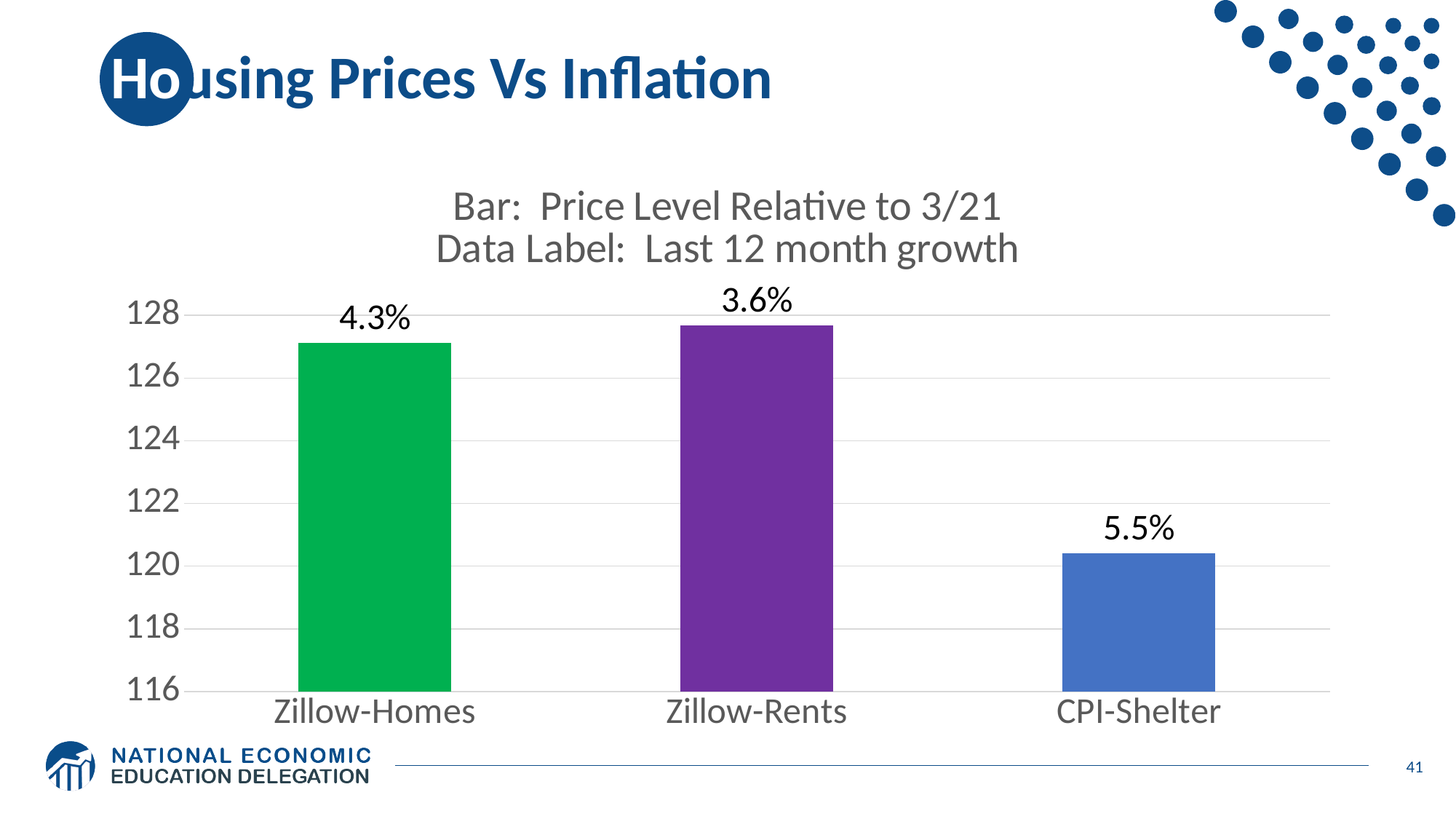
Which bar is taller, Zillow-Homes or CPI-Shelter? Zillow-Homes What is the difference between the CPI-Shelter data label and the Zillow-Rents data label? 1.9 percentage points What is the data label shown above the Zillow-Rents bar? 3.6% How many categories are shown on the x axis? 3 Is the bar for Zillow-Homes greater or less than 126? greater Is the bar for CPI-Shelter greater or less than 122? less Which category has the shortest bar (lowest price level relative to 3/21)? CPI-Shelter What is the data label shown above the CPI-Shelter bar? 5.5% What is the data label shown above the Zillow-Homes bar? 4.3% Which category has the lowest last-12-month growth data label? Zillow-Rents Which category has the highest last-12-month growth data label? CPI-Shelter What kind of chart is shown on the slide? Bar chart